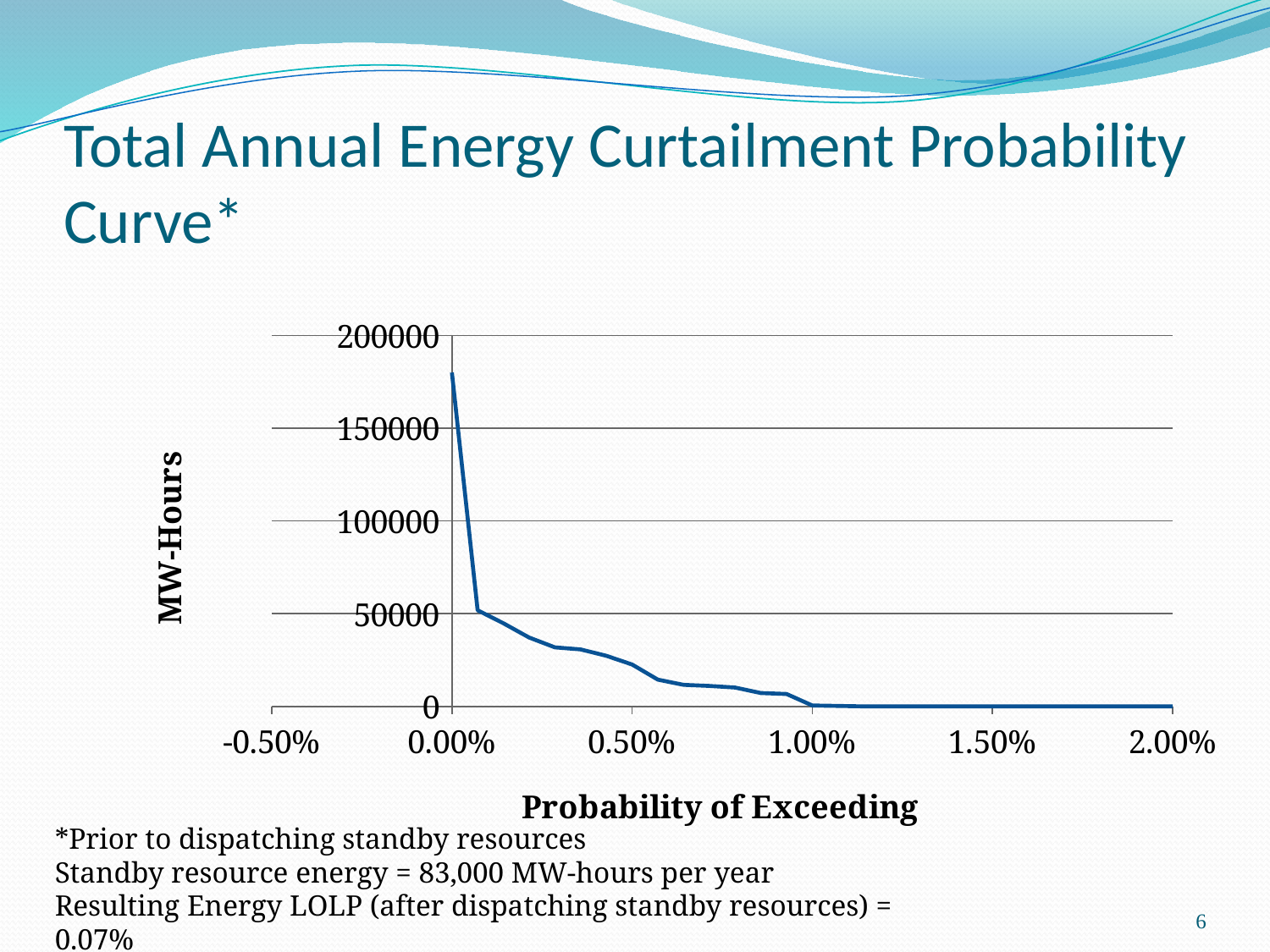
Do the MW-Hours values rise or fall as Probability of Exceeding increases along the x axis? fall Is the MW-Hours value at a Probability of Exceeding of 0.50% greater or less than 50000? less Is the MW-Hours value at a Probability of Exceeding of 1.50% greater or less than 50000? less Is the MW-Hours value at a Probability of Exceeding of 0.00% greater or less than 150000? greater Which has the larger MW-Hours value: a Probability of Exceeding of 0.00% or 1.00%? 0.00% What is the title of the chart on the slide? Total Annual Energy Curtailment Probability Curve* What kind of chart is shown on the slide? line chart At which Probability of Exceeding value on the x axis does the curve reach its highest MW-Hours value? 0.00% What is the highest value shown on the y axis? 200000 What is the label of the y axis? MW-Hours